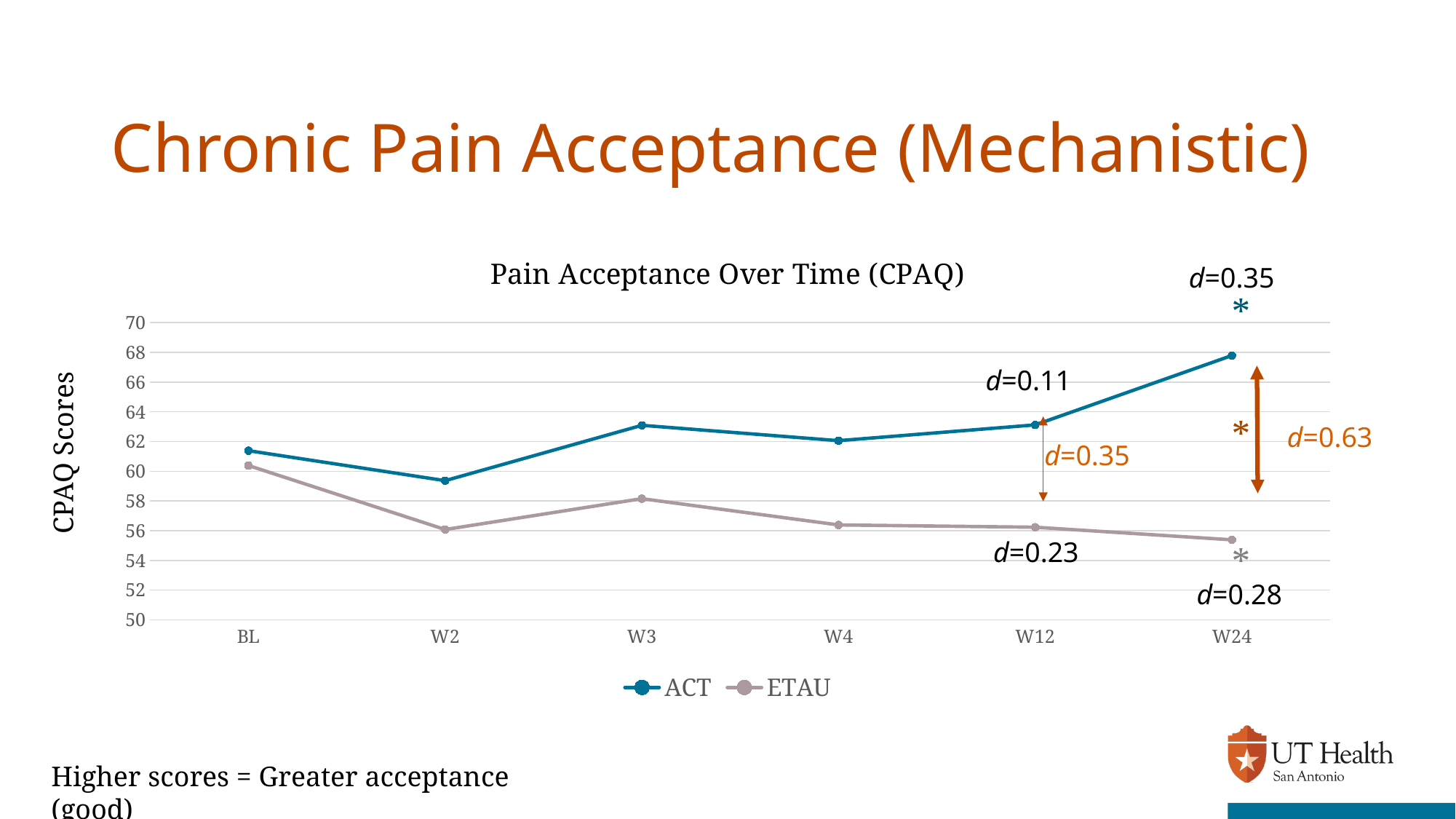
At which time point is the ACT score lowest? W2 At W24, which series has the higher CPAQ score, ACT or ETAU? ACT Does the ACT line rise or fall from W4 to W24? rise Is the ACT value at W24 greater or less than 66? greater At which time point is the ETAU score highest? BL How many series does the legend list? 2 What is the title of the chart? Pain Acceptance Over Time (CPAQ) At which time point is the ACT score highest? W24 What kind of chart is shown on the slide? line chart How many time points are plotted along the x axis? 6 Is the ETAU value at W12 greater or less than 58? less What is the label on the y axis? CPAQ Scores